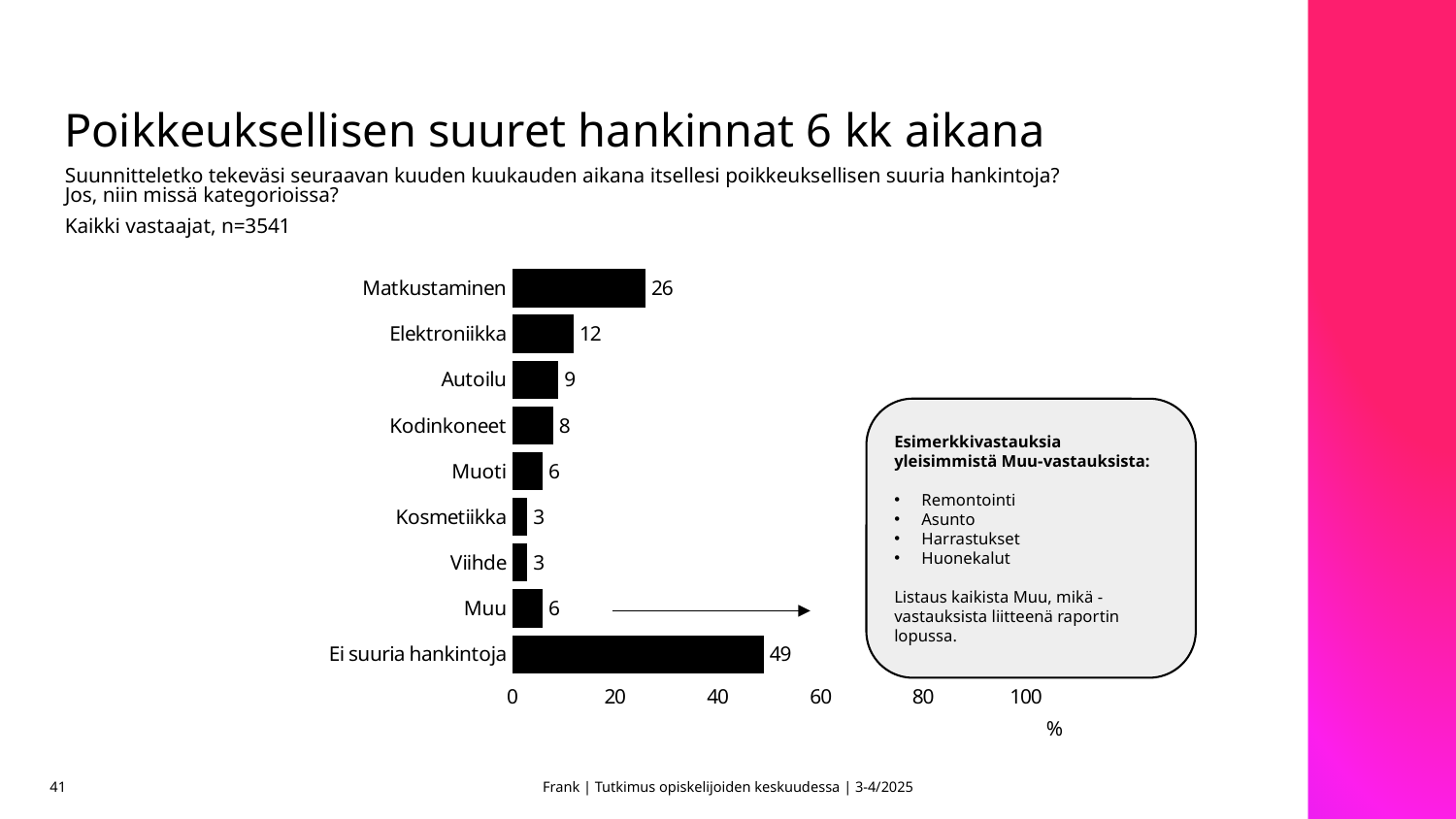
What is the value for Viihde? 3 Which is larger, the value for Autoilu or the value for Muoti? Autoilu Which category has the highest value? Ei suuria hankintoja What is the title of the slide containing the chart? Poikkeuksellisen suuret hankinnat 6 kk aikana What is the difference between the values for Matkustaminen and Elektroniikka? 14 How many categories are shown in the chart? 9 Is the value for Ei suuria hankintoja greater or less than 40? greater What is the value for Kodinkoneet? 8 What kind of chart is shown on the slide? bar chart What is the value for Ei suuria hankintoja? 49 What is the value for Matkustaminen? 26 What is the difference between the values for Ei suuria hankintoja and Matkustaminen? 23